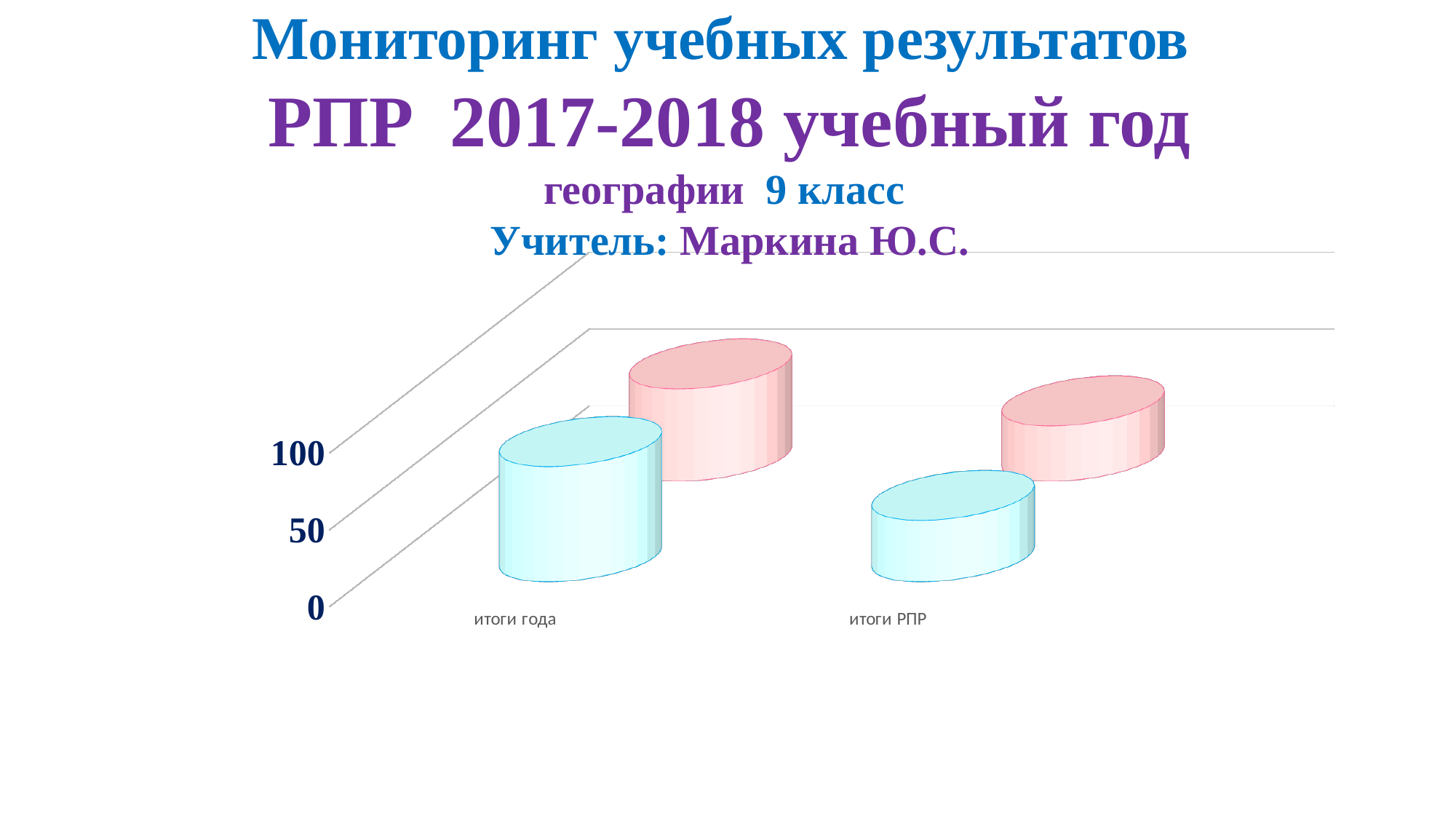
Is the blue bar for итоги года greater or less than 50? greater How many bars are plotted in the chart in total? 4 How many categories are shown on the x axis of the chart? 2 Is the pink bar for итоги года greater or less than 50? greater Which category has the lowest blue bar in the chart? итоги РПР Do the values of the blue series rise or fall from итоги года to итоги РПР? fall What are the two category labels on the x axis of the chart? итоги года, итоги РПР For the pink series, which category has the higher value: итоги года or итоги РПР? итоги года Do the values of the pink series rise or fall from итоги года to итоги РПР? fall What kind of chart is shown on the slide? bar chart For the blue series, which category has the higher value: итоги года or итоги РПР? итоги года What is the highest tick value shown on the vertical axis of the chart? 100